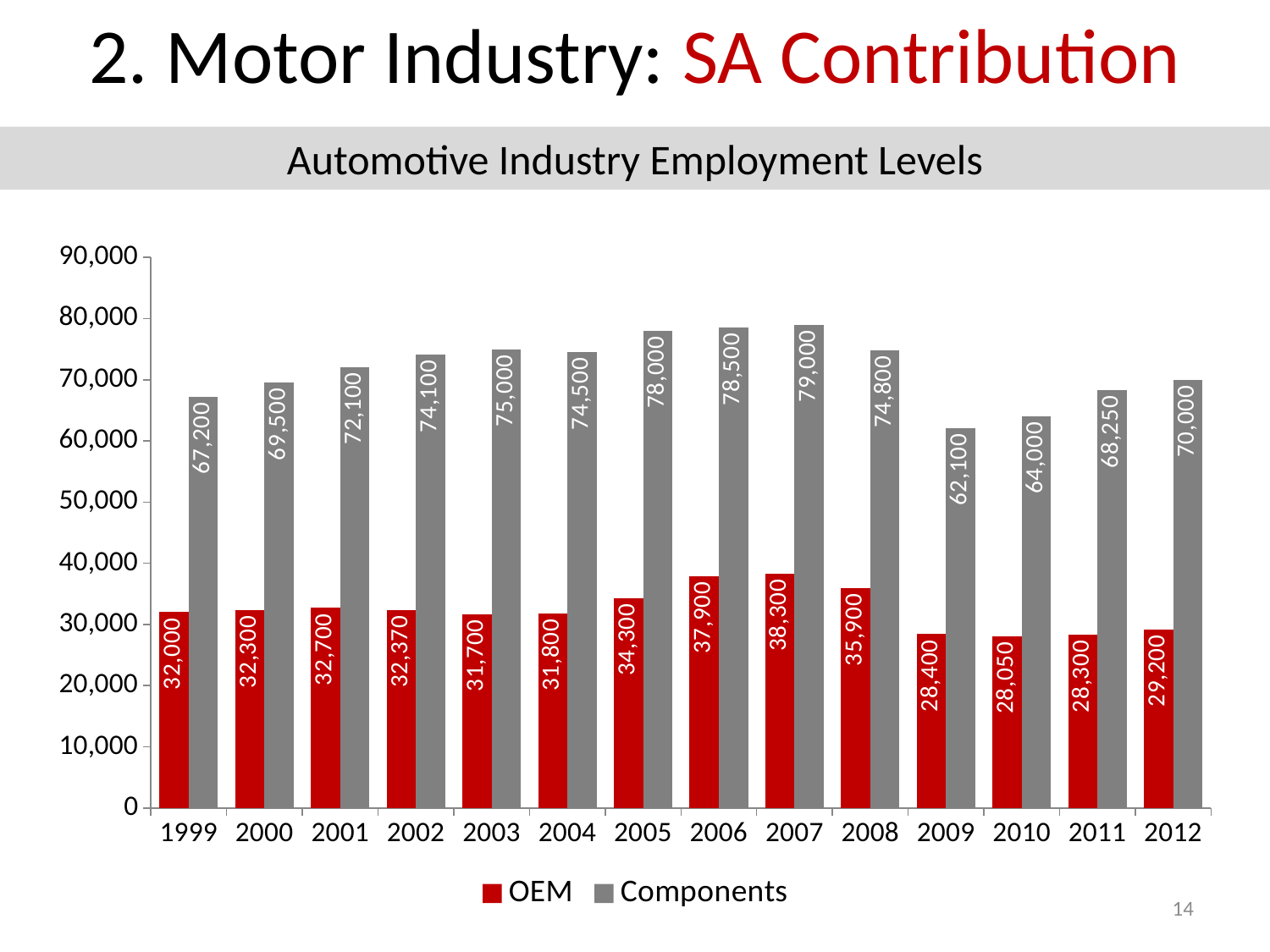
What is the OEM employment level in 2007? 38,300 Which year has the highest Components employment level? 2007 What is the difference between Components and OEM employment in 2012? 40,800 Is the Components value for 2005 greater or less than 70,000? greater What is the Components employment level in 2009? 62,100 What kind of chart is shown on the slide? Bar chart How many series does the legend list? 2 How many years are shown on the x axis? 14 Which is larger, OEM employment in 2006 or OEM employment in 2008? 2006 What colour represents the Components series? Grey Do the OEM values rise or fall from 2008 to 2010? Fall Which year has the lowest OEM employment level? 2010